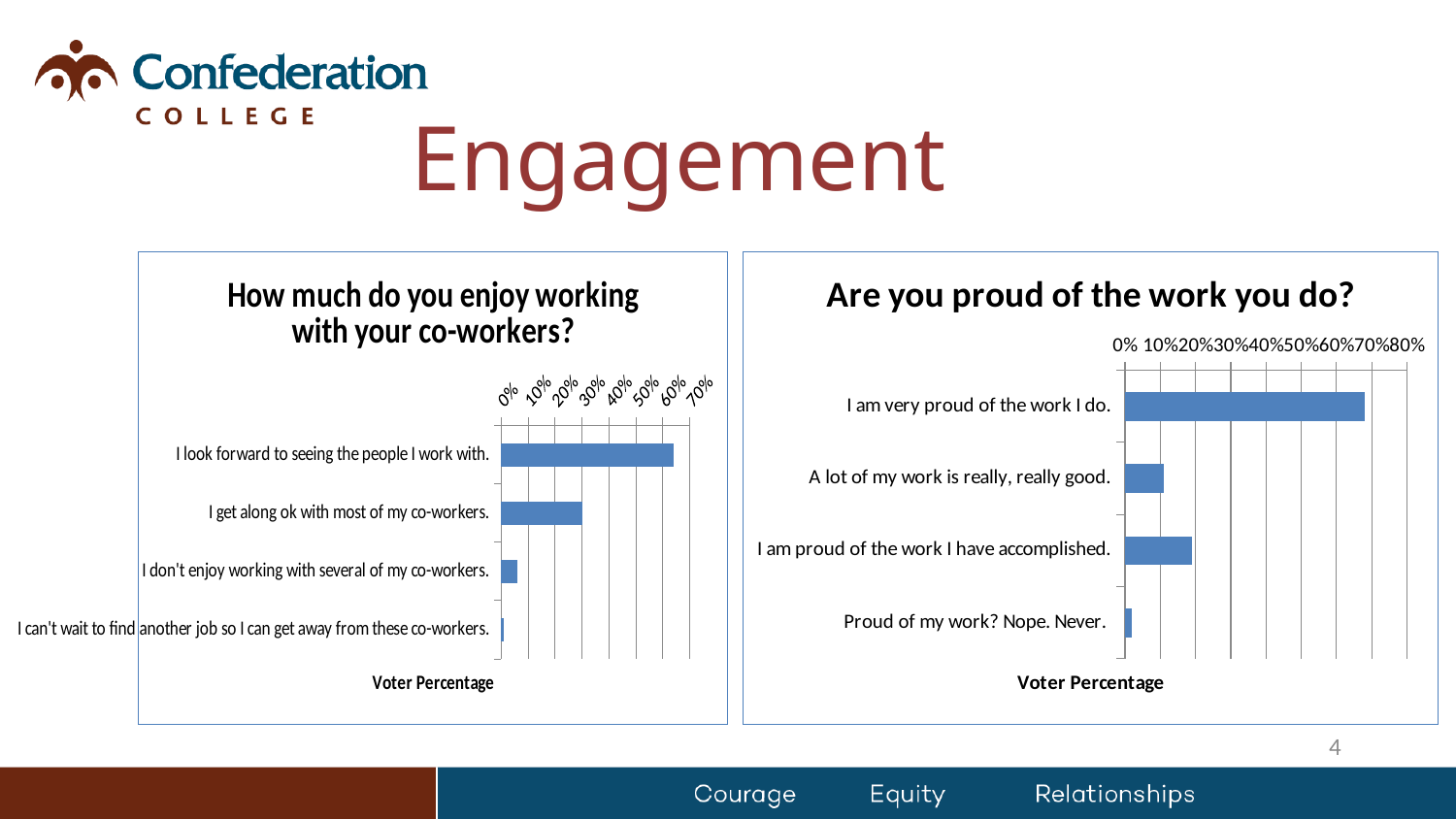
In the chart "How much do you enjoy working with your co-workers?", is the value for "I look forward to seeing the people I work with." greater or less than 50%? greater In the chart "Are you proud of the work you do?", which category has the lowest value? Proud of my work? Nope. Never. How many categories does the chart "Are you proud of the work you do?" show? 4 In the chart "Are you proud of the work you do?", which category has the highest value? I am very proud of the work I do. In the chart "Are you proud of the work you do?", which is larger: "A lot of my work is really, really good." or "I am proud of the work I have accomplished."? I am proud of the work I have accomplished. What kind of chart is "How much do you enjoy working with your co-workers?"? bar chart In the chart "How much do you enjoy working with your co-workers?", is the value for "I get along ok with most of my co-workers." greater or less than 40%? less In the chart "Are you proud of the work you do?", is the value for "A lot of my work is really, really good." greater or less than 20%? less What is the axis title shown below the bars in the chart "Are you proud of the work you do?"? Voter Percentage In the chart "How much do you enjoy working with your co-workers?", which category has the lowest value? I can't wait to find another job so I can get away from these co-workers. In the chart "How much do you enjoy working with your co-workers?", which category has the highest value? I look forward to seeing the people I work with.